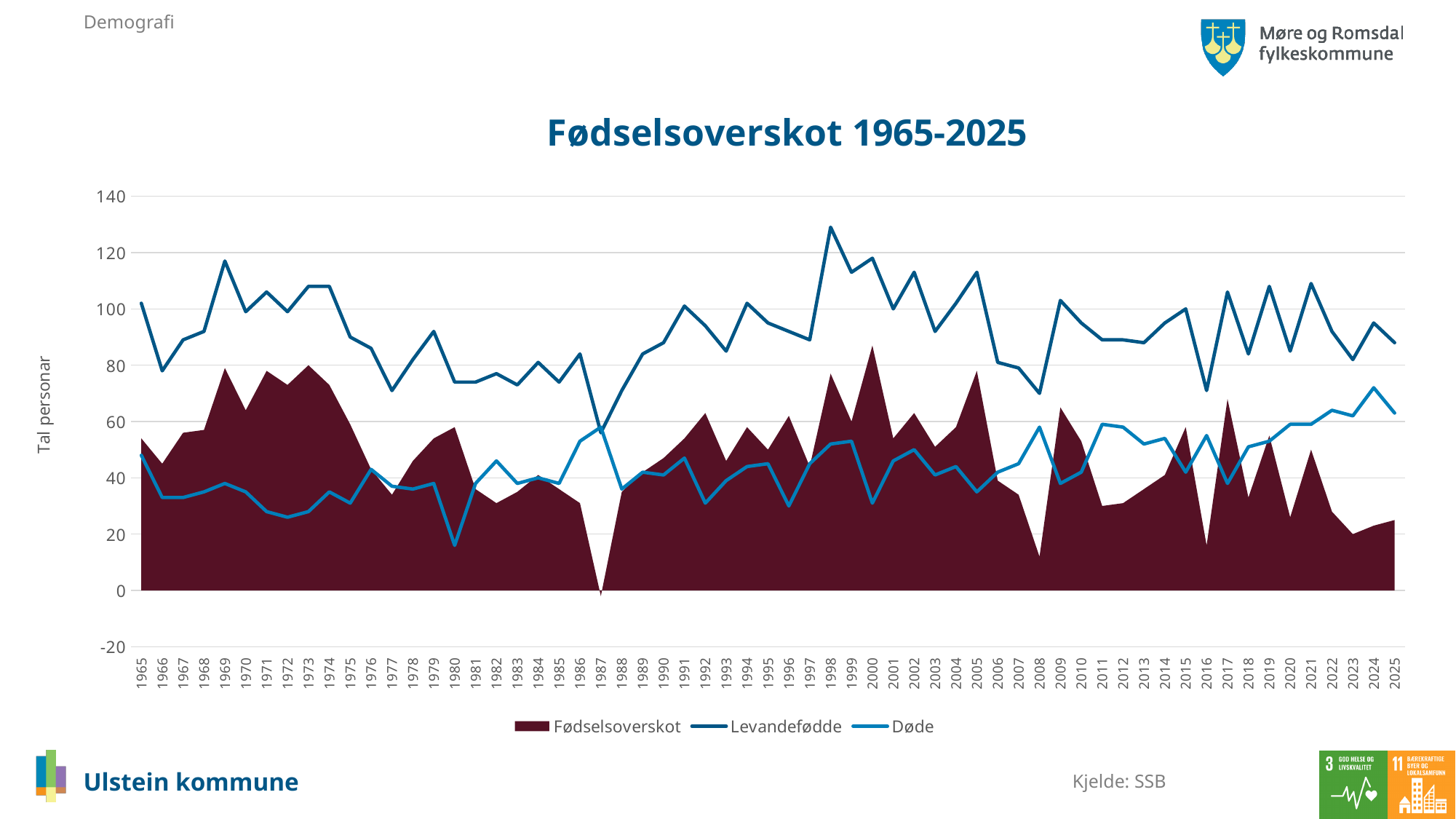
What is the title of the chart? Fødselsoverskot 1965-2025 How many series does the chart legend list? 3 In which year does the Levandefødde line reach its lowest value? 1987 Which year has the larger Levandefødde value, 1969 or 1977? 1969 What is the label on the vertical axis of the chart? Tal personar Is the Døde value for 1980 greater or less than 20? less What kind of chart is shown on the slide? area and line chart In which year does the Døde line reach its lowest value? 1980 Is the Levandefødde value for 1998 greater or less than 120? greater In which year is the Fødselsoverskot area at its lowest? 1987 From 1980 to 2025, does the Døde line generally rise or fall? rise In which year does the Levandefødde line reach its highest value? 1998